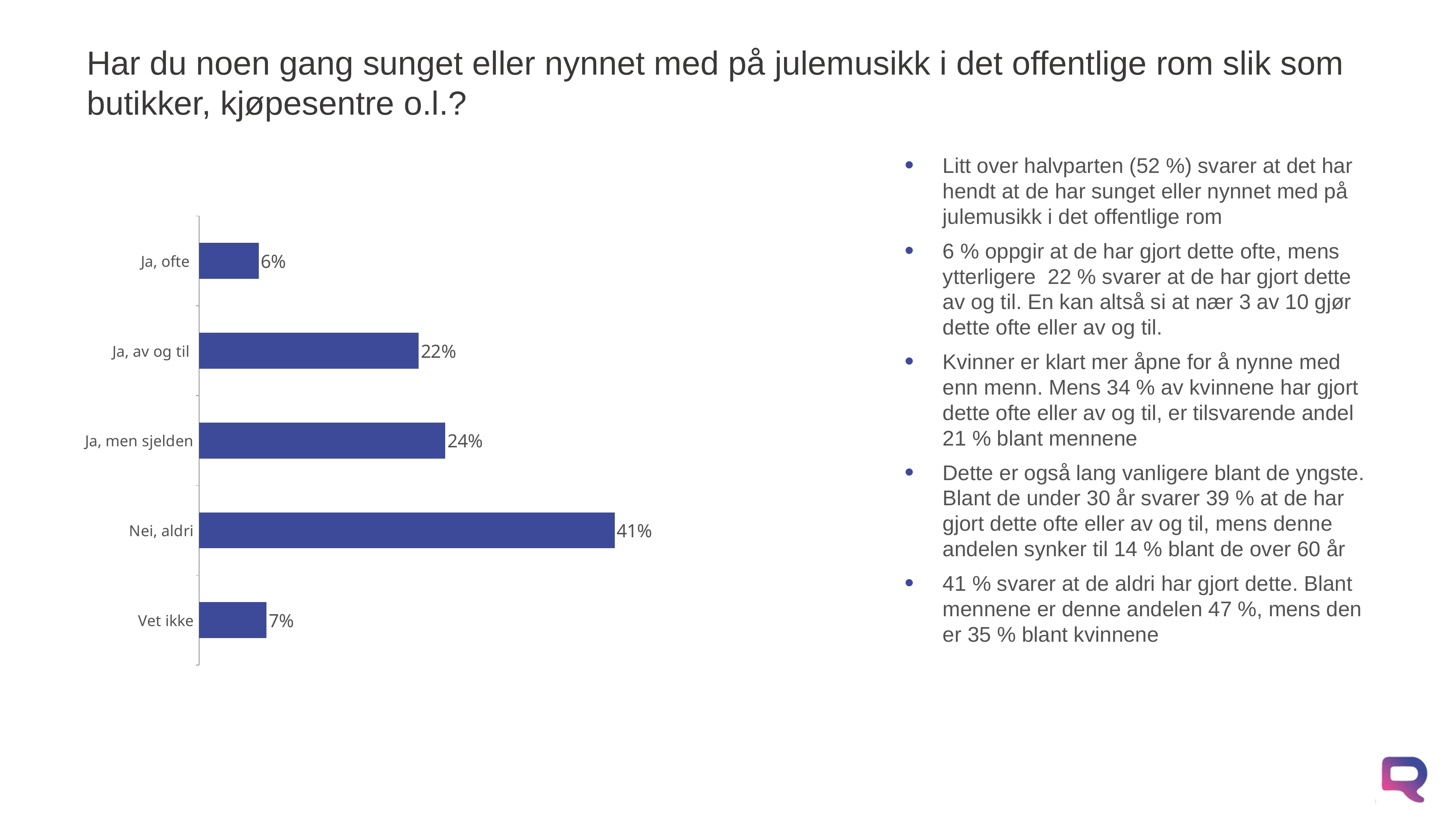
Which category has the highest value? Nei, aldri What is the value for "Nei, aldri"? 41% What is the difference between the values for "Nei, aldri" and "Ja, men sjelden"? 17% What kind of chart is shown on the slide? Bar chart Which category has the lowest value? Ja, ofte What is the value for "Ja, men sjelden"? 24% What is the value for "Ja, av og til"? 22% What is the value for "Ja, ofte"? 6% What is the value for "Vet ikke"? 7% Which is larger, the value for "Ja, av og til" or the value for "Vet ikke"? Ja, av og til How many categories are shown in the chart? 5 What is the combined value of "Ja, ofte" and "Ja, av og til"? 28%